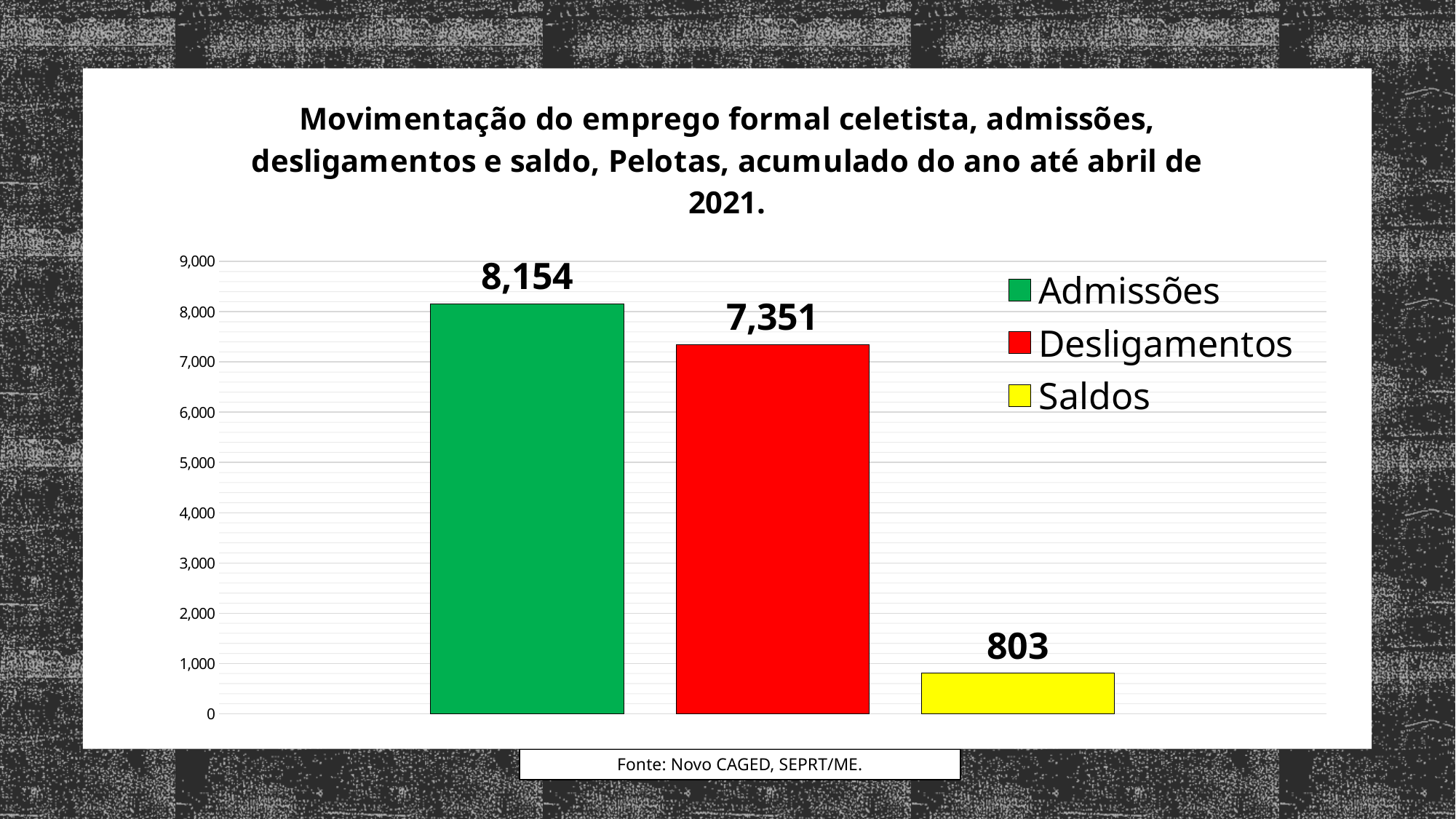
Which series has the highest value? Admissões What is the value for Admissões? 8,154 What kind of chart is shown on the slide? bar chart Which is larger, Admissões or Desligamentos? Admissões Which series has the lowest value? Saldos What is the value for Saldos? 803 Is the value for Saldos greater or less than 1,000? less What colour is the bar for Desligamentos? red What is the difference between Admissões and Desligamentos? 803 How many series does the legend list? 3 What is the value for Desligamentos? 7,351 What is the difference between Desligamentos and Saldos? 6,548